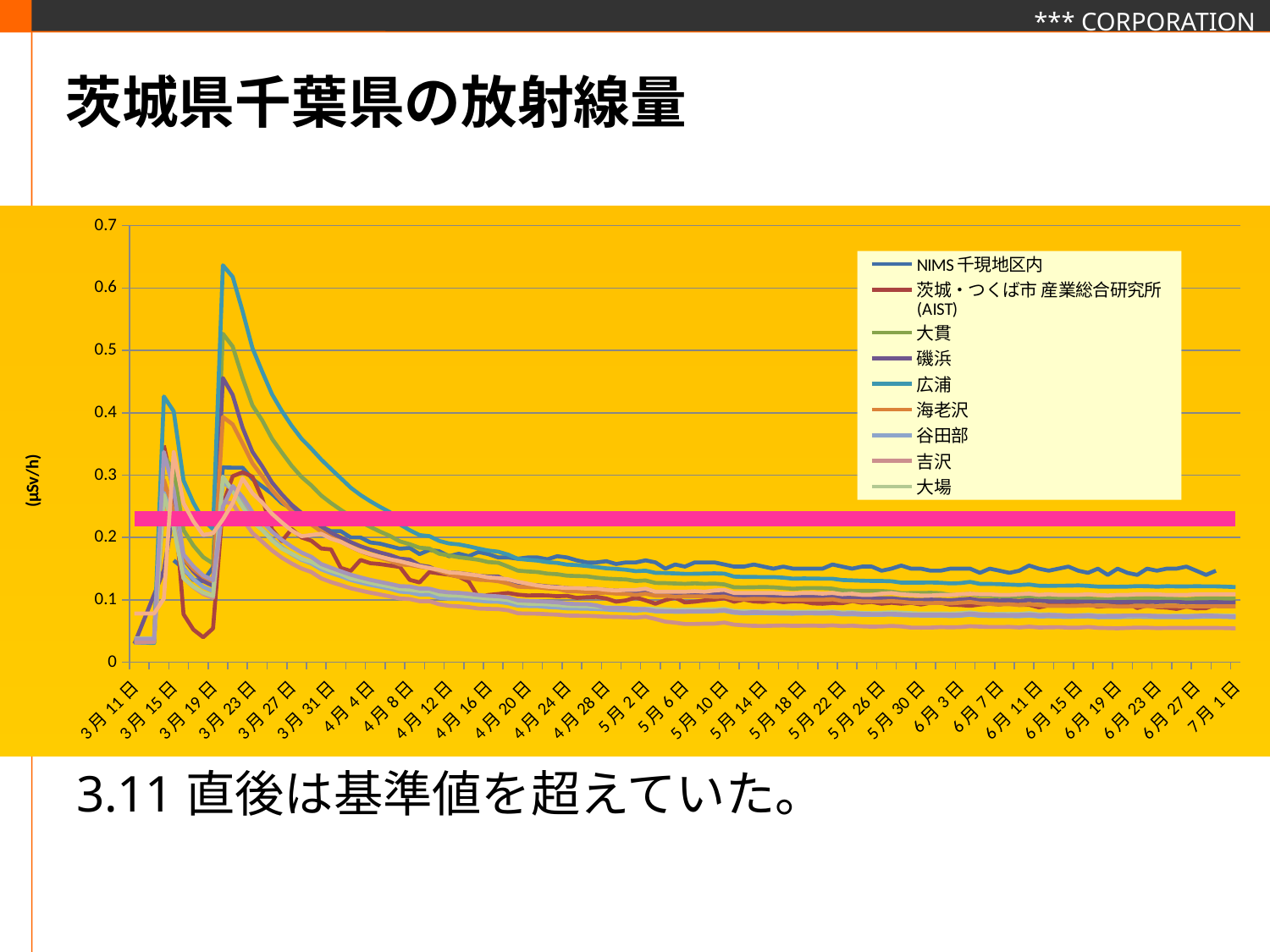
What is the highest tick value shown on the vertical axis? 0.7 What unit is shown on the vertical axis of the chart? μSv/h Which series is listed first in the legend? NIMS 千現地区内 Is the level of the horizontal pink reference band greater or less than 0.3? less What is the last date label on the horizontal axis? 7月1日 From late March (3月23日) to 7月1日, do the plotted lines generally rise or fall? fall Is the highest peak reached by any line in the chart greater or less than 0.6? greater What kind of chart is shown on the slide? line chart What is the title of the slide containing the chart? 茨城県千葉県の放射線量 How many series does the legend of the chart list? 9 What is the first date label on the horizontal axis? 3月11日